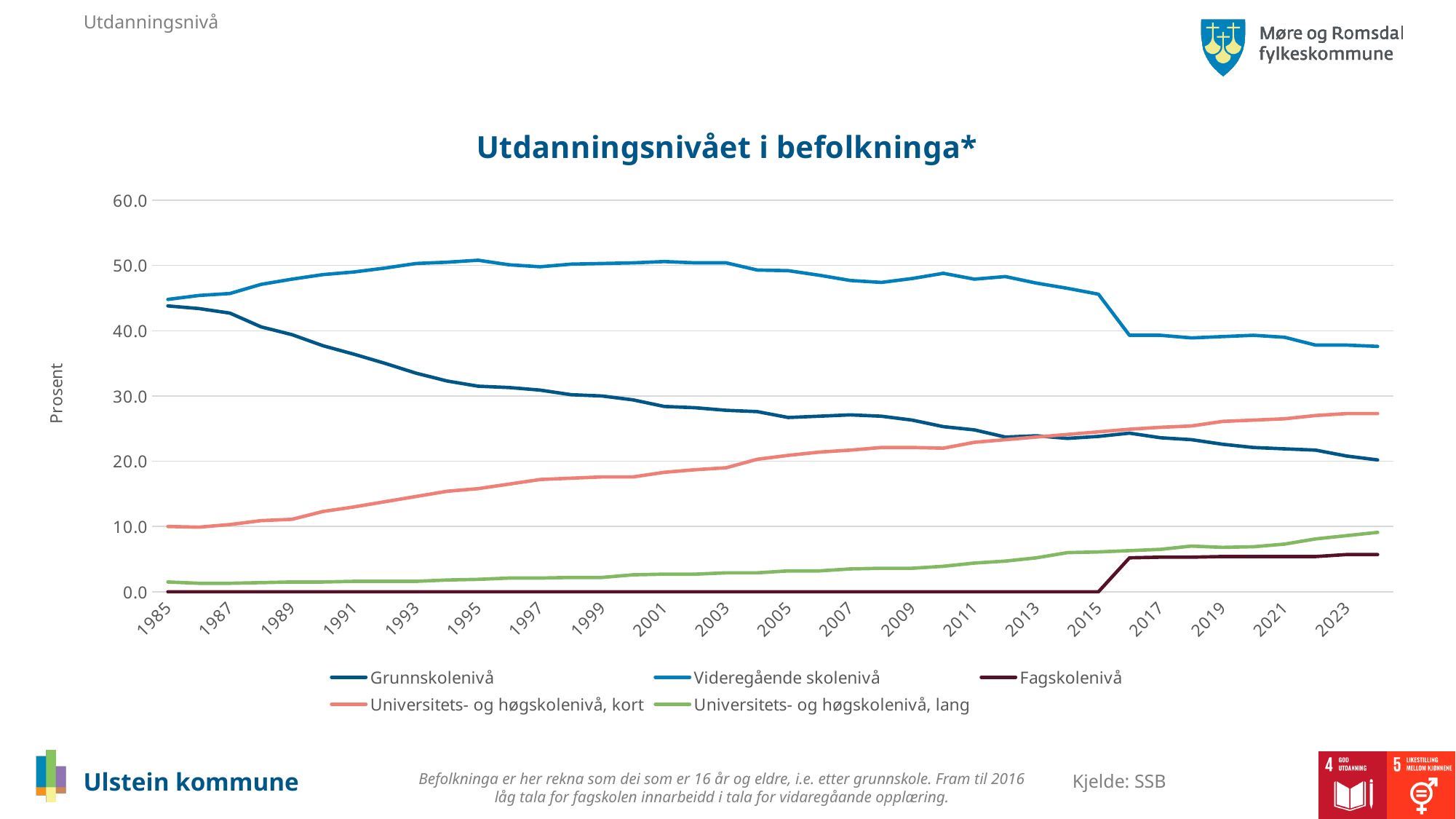
How many series does the legend list? 5 What is the label on the vertical axis? Prosent Does the value for Universitets- og høgskolenivå, kort rise or fall from 1985 to 2023? rise In 2023, which is larger: Universitets- og høgskolenivå, kort or Grunnskolenivå? Universitets- og høgskolenivå, kort What is the title of the chart? Utdanningsnivået i befolkninga* What kind of chart is shown on the slide? line chart Which series has the highest value in 2023? Videregående skolenivå Does the value for Grunnskolenivå rise or fall from 1985 to 2023? fall Which series has the lowest value in 1995? Fagskolenivå Is the value for Grunnskolenivå in 2023 greater or less than 30.0? less Is the value for Videregående skolenivå in 1995 greater or less than 50.0? greater What is the value for Fagskolenivå in 2005? 0.0